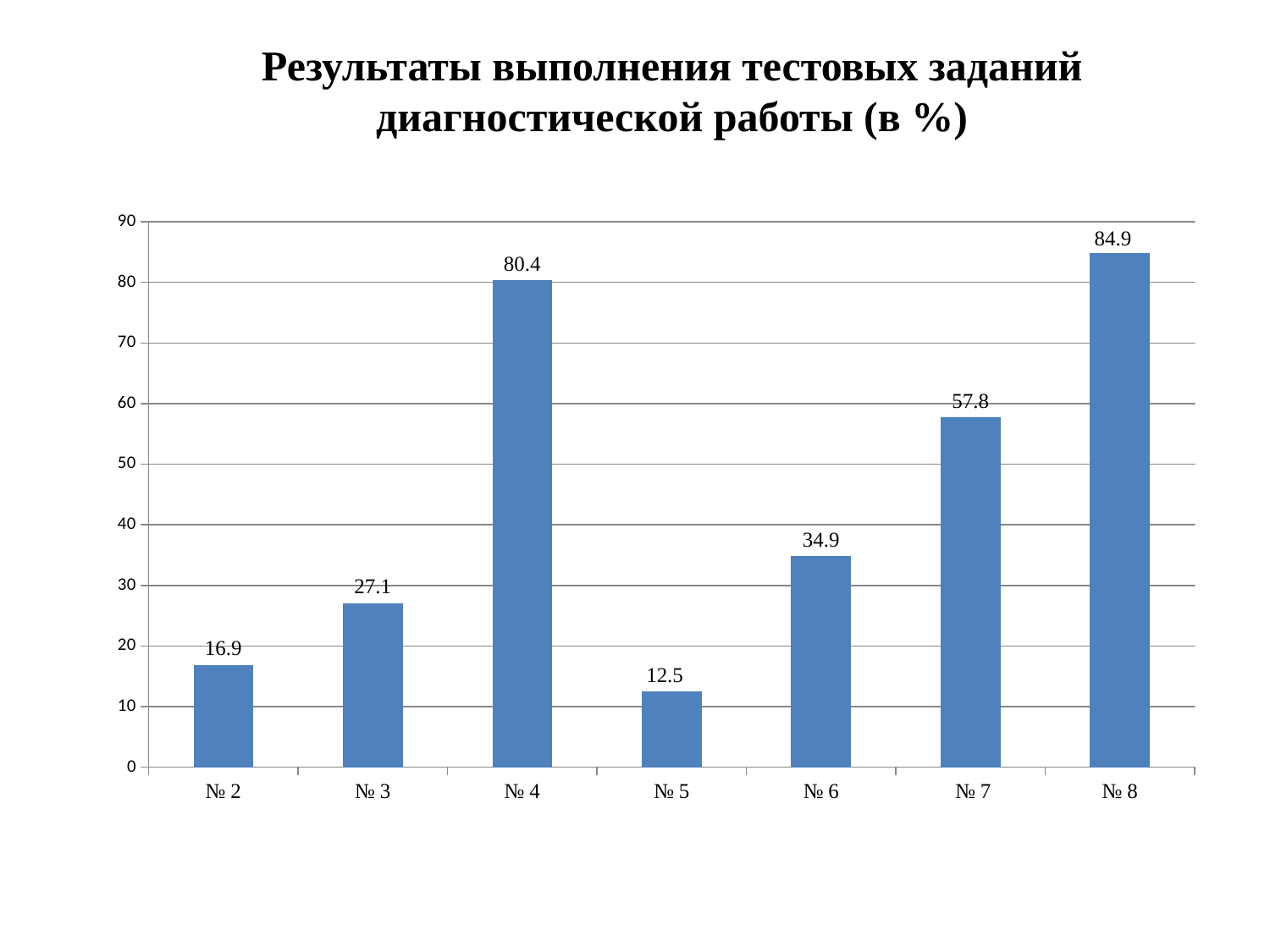
Which category has the highest value? № 8 What is the value for № 6? 34.9 Which is larger, the value for № 6 or the value for № 3? № 6 Is the value for № 7 greater or less than 50? greater What is the value for № 5? 12.5 How many categories are shown on the x axis? 7 Which category has the lowest value? № 5 What is the difference between the values for № 8 and № 7? 27.1 What is the difference between the values for № 3 and № 2? 10.2 What kind of chart is shown on the slide? bar chart What is the title of the chart? Результаты выполнения тестовых заданий диагностической работы (в %) What is the value for № 4? 80.4